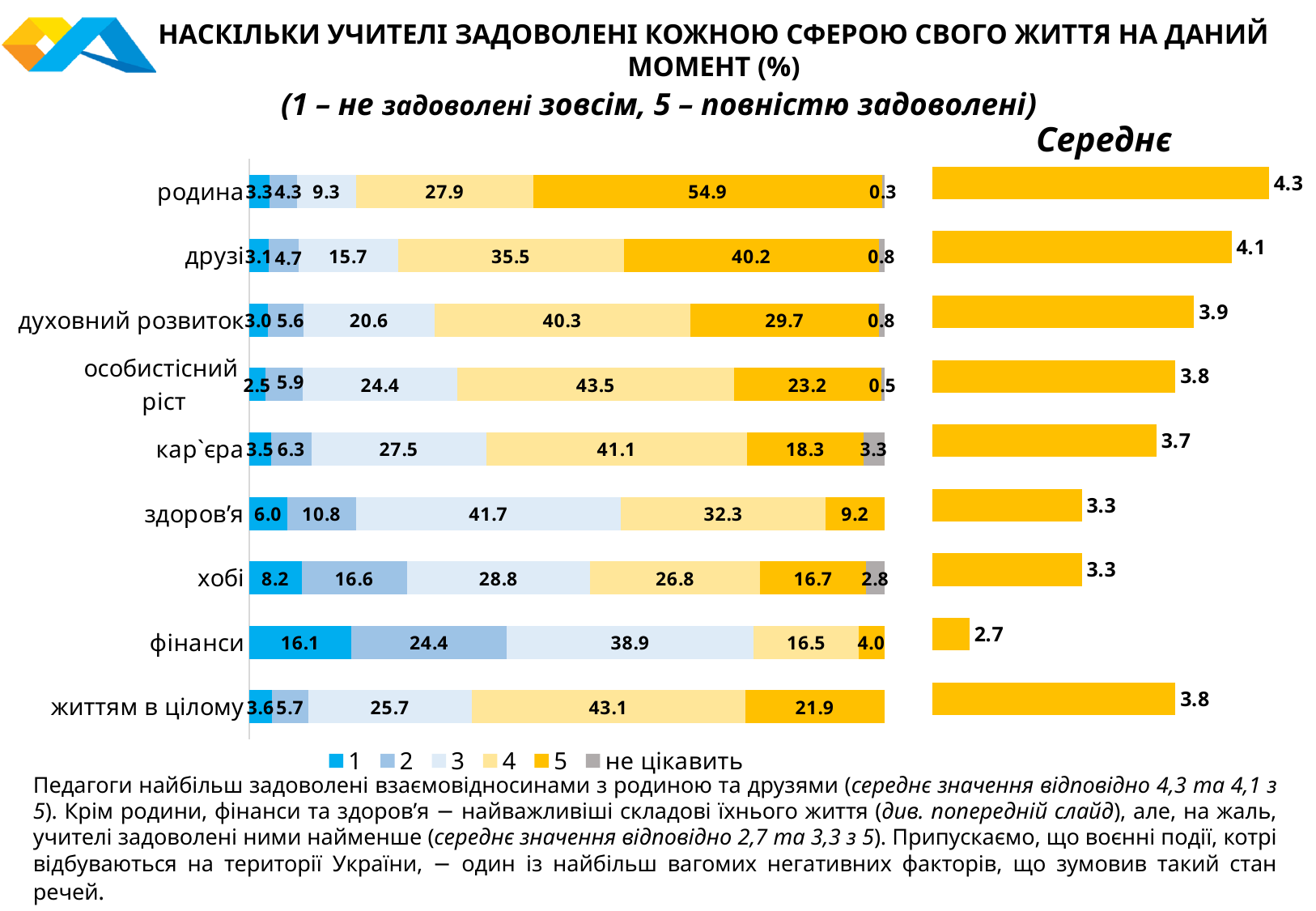
In the right chart (Середнє), which category has the lowest average? фінанси In the right chart (Середнє), what is the average value for фінанси? 2.7 In the left stacked bar chart, which has a larger share of rating 4: особистісний ріст or кар`єра? особистісний ріст In the right chart (Середнє), which category has the highest average? родина In the left stacked bar chart, what percentage of teachers rated здоров'я as 3? 41.7 In the right chart (Середнє), what is the difference between the averages for родина and друзі? 0.2 In the left stacked bar chart, what percentage of teachers rated родина as 5? 54.9 How many series does the legend of the left stacked bar chart list? 6 In the left stacked bar chart, what is the difference between the share rating родина as 5 and the share rating друзі as 5? 14.7 In the left stacked bar chart, what percentage of teachers rated фінанси as 1? 16.1 How many categories (life spheres) are shown in the left stacked bar chart? 9 What type of chart is the left chart on the slide? stacked bar chart